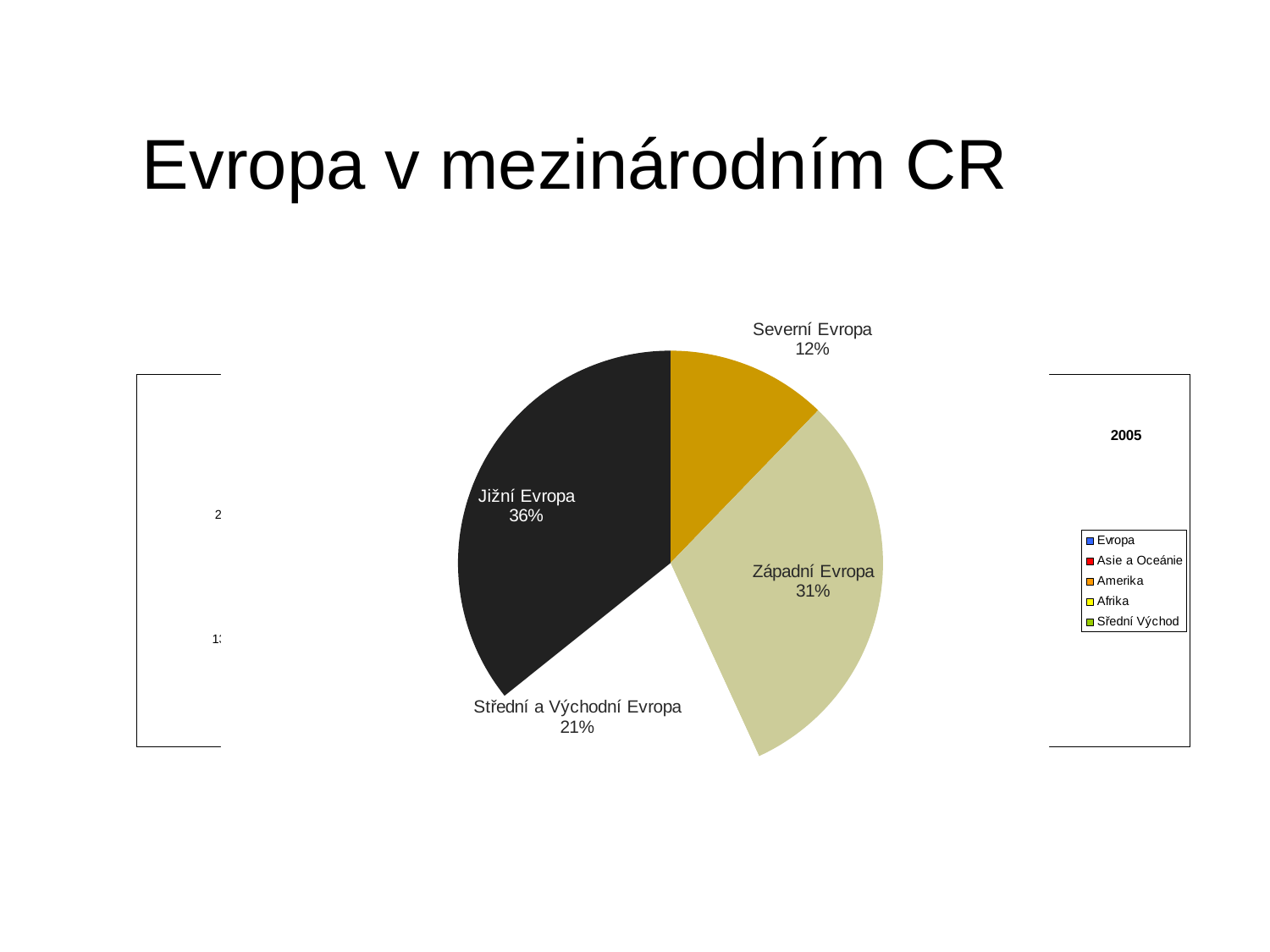
In the pie chart, which region has the smallest share? Severní Evropa In the pie chart, which has the larger share, Západní Evropa or Střední a Východní Evropa? Západní Evropa How many entries does the legend on the right side of the slide list? 5 In the pie chart, what share does Západní Evropa have? 31% In the pie chart, which region has the largest share? Jižní Evropa In the pie chart, what share does Jižní Evropa have? 36% What kind of chart is shown in the centre of the slide? pie chart In the pie chart, what share does Severní Evropa have? 12% How many slices does the pie chart have? 4 In the pie chart, what is the difference in percentage points between Jižní Evropa and Severní Evropa? 24 In the pie chart, what share does Střední a Východní Evropa have? 21% In the pie chart, which region is shown in the darkest (black) slice? Jižní Evropa